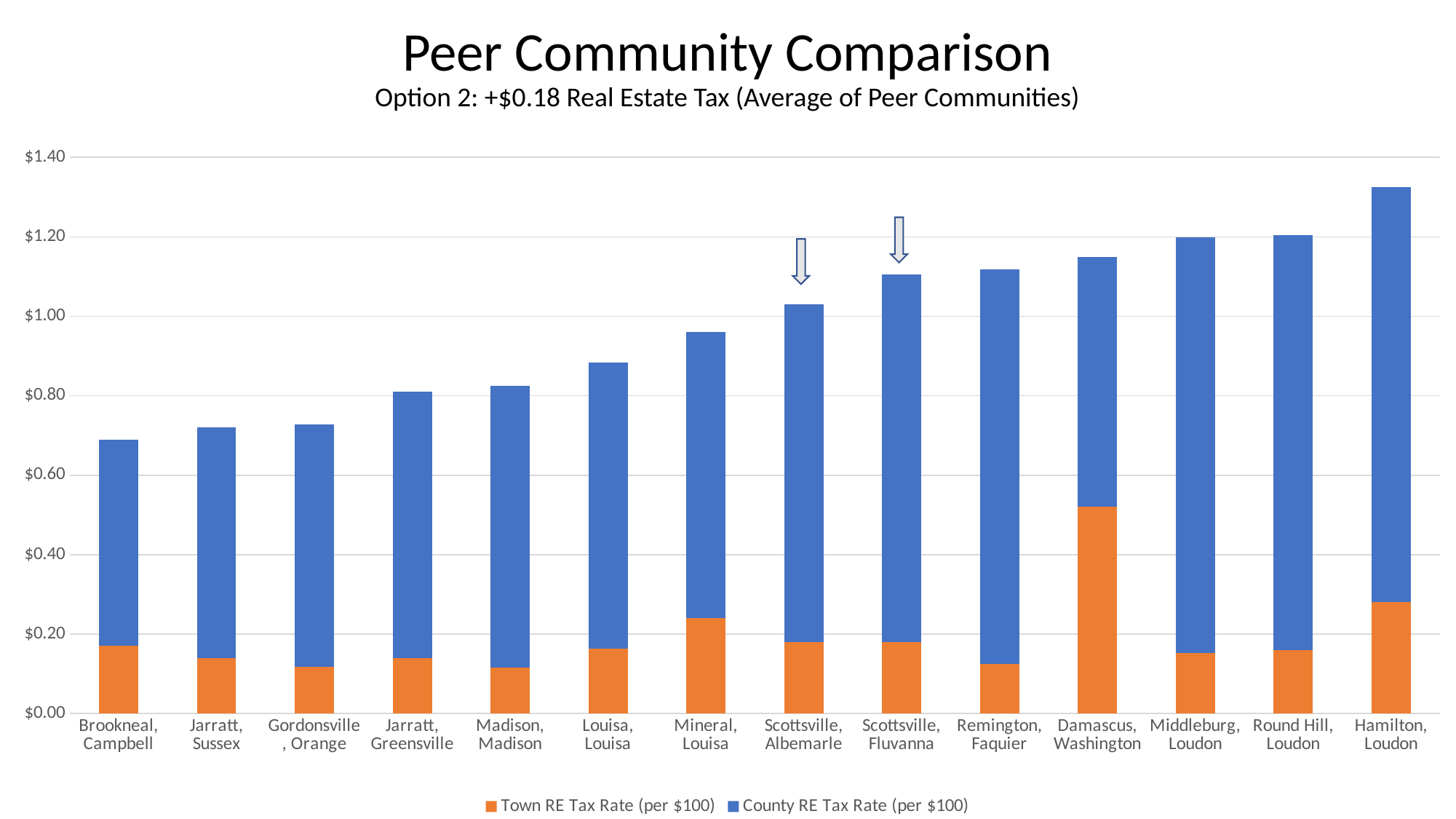
Is the total bar for Hamilton, Loudon greater or less than $1.20? greater Is the total bar for Brookneal, Campbell greater or less than $0.80? less What kind of chart is shown on the slide? Stacked bar chart How many peer communities are plotted along the x axis? 14 Which has the larger total bar, Remington, Faquier or Louisa, Louisa? Remington, Faquier Which community has the highest Town RE Tax Rate (orange segment)? Damascus, Washington Which community has the lowest total real estate tax rate? Brookneal, Campbell How many series does the legend list? 2 What is the subtitle shown under the chart title? Option 2: +$0.18 Real Estate Tax (Average of Peer Communities) Do the total bar heights generally rise or fall from left to right across the x axis? Rise Which community has the highest total real estate tax rate? Hamilton, Loudon Is the Town RE Tax Rate for Damascus, Washington greater or less than $0.40? greater